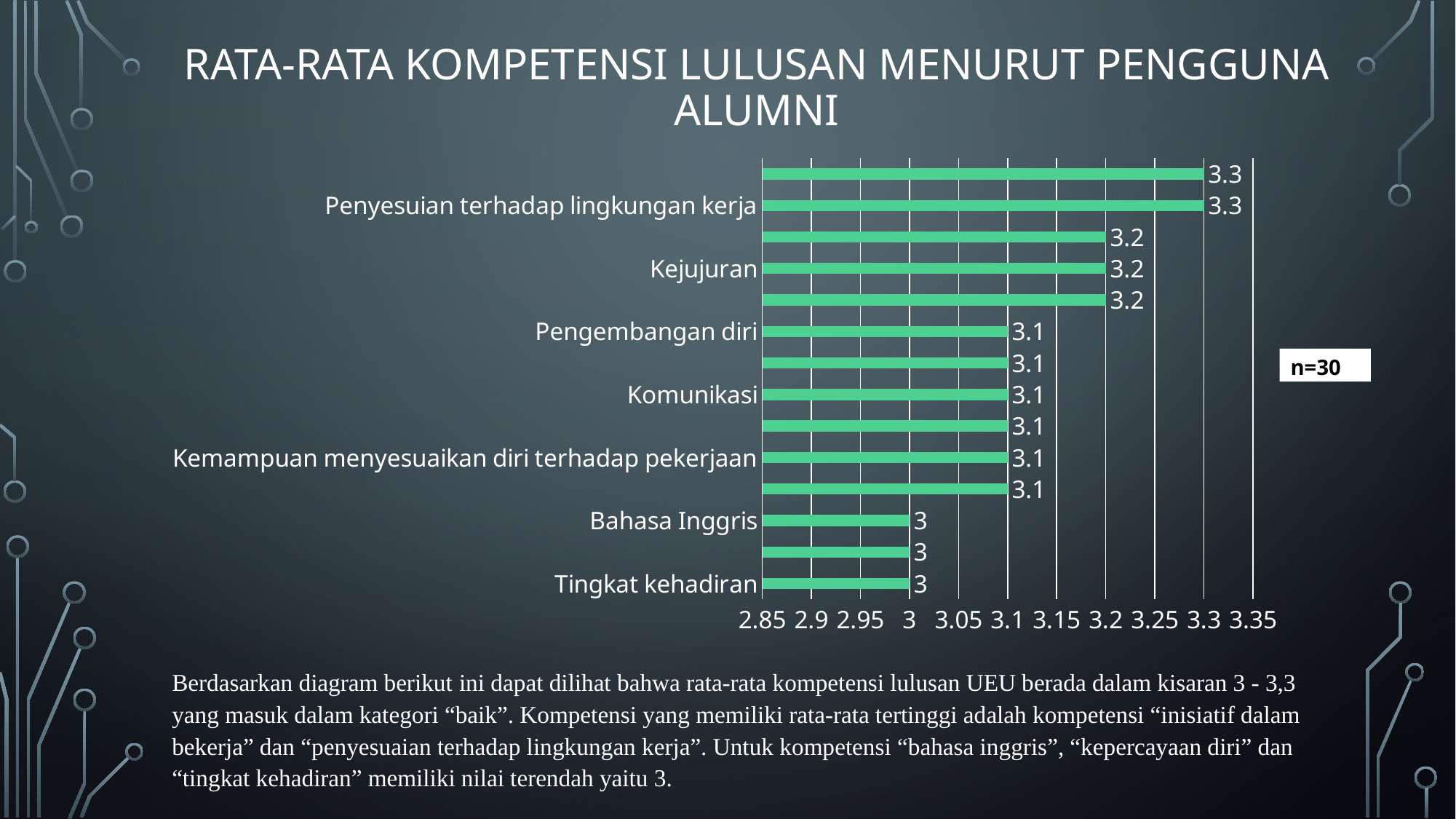
What is the value for Tingkat kehadiran? 3 What is the value for Kejujuran? 3.2 What is the value for Penyesuian terhadap lingkungan kerja? 3.3 Which is larger, the value for Kejujuran or the value for Komunikasi? Kejujuran What sample size is noted in the box next to the chart? n=30 What is the value for Bahasa Inggris? 3 What is the value for Komunikasi? 3.1 What kind of chart is shown on the slide? bar chart How many bars are plotted in the chart? 14 What is the value for Pengembangan diri? 3.1 What is the difference between the values for Penyesuian terhadap lingkungan kerja and Tingkat kehadiran? 0.3 Is the value for Kemampuan menyesuaikan diri terhadap pekerjaan greater or less than 3.2? less